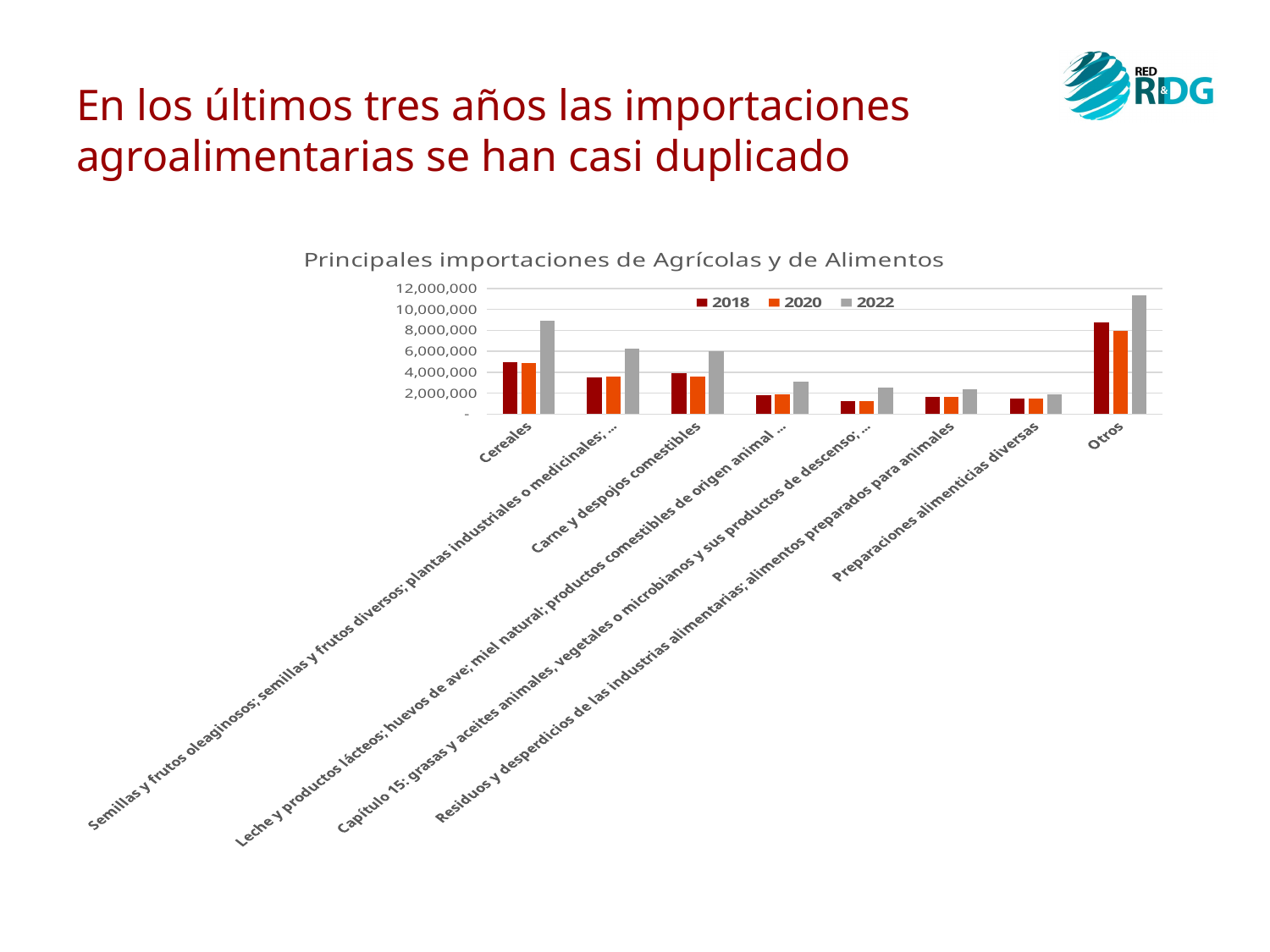
Which category has the highest value for 2022? Otros How many categories are shown on the x axis of the chart? 8 What is the title of the chart? Principales importaciones de Agrícolas y de Alimentos Is the 2022 value for Cereales greater or less than 8,000,000? greater Which years are listed in the chart legend? 2018, 2020, 2022 Is the 2018 value for Capítulo 15: grasas y aceites animales, vegetales o microbianos greater or less than 2,000,000? less Is the 2022 value for Otros greater or less than 10,000,000? greater Which is larger for 2018: Cereales or Carne y despojos comestibles? Cereales What kind of chart is shown on the slide? Bar chart Which category has the lowest value for 2022? Preparaciones alimenticias diversas How many series does the chart legend list? 3 For Cereales, do the values rise or fall from 2020 to 2022? rise